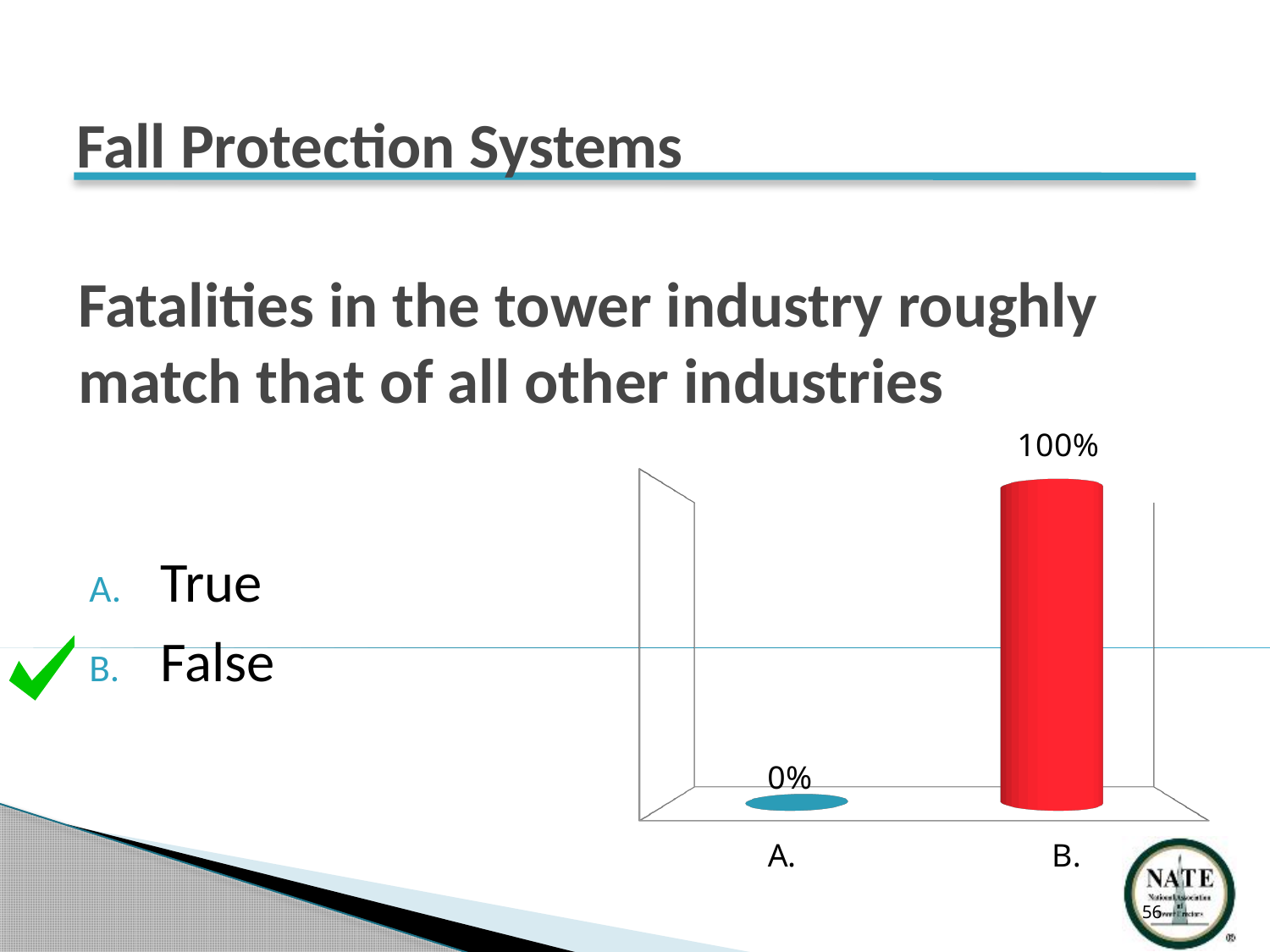
Which category has the larger value, A. or B.? B. What colour is the bar for category B.? red Which category has the highest value in the chart? B. Which category has the lowest value in the chart? A. What is the difference between the values for B. and A. in the chart? 100% What kind of chart is shown on the slide? bar chart How many categories are shown on the x axis of the chart? 2 What is the value shown for category B. in the chart? 100% What colour is the marker for category A.? blue Do the values rise or fall from category A. to category B.? rise What is the value shown for category A. in the chart? 0%